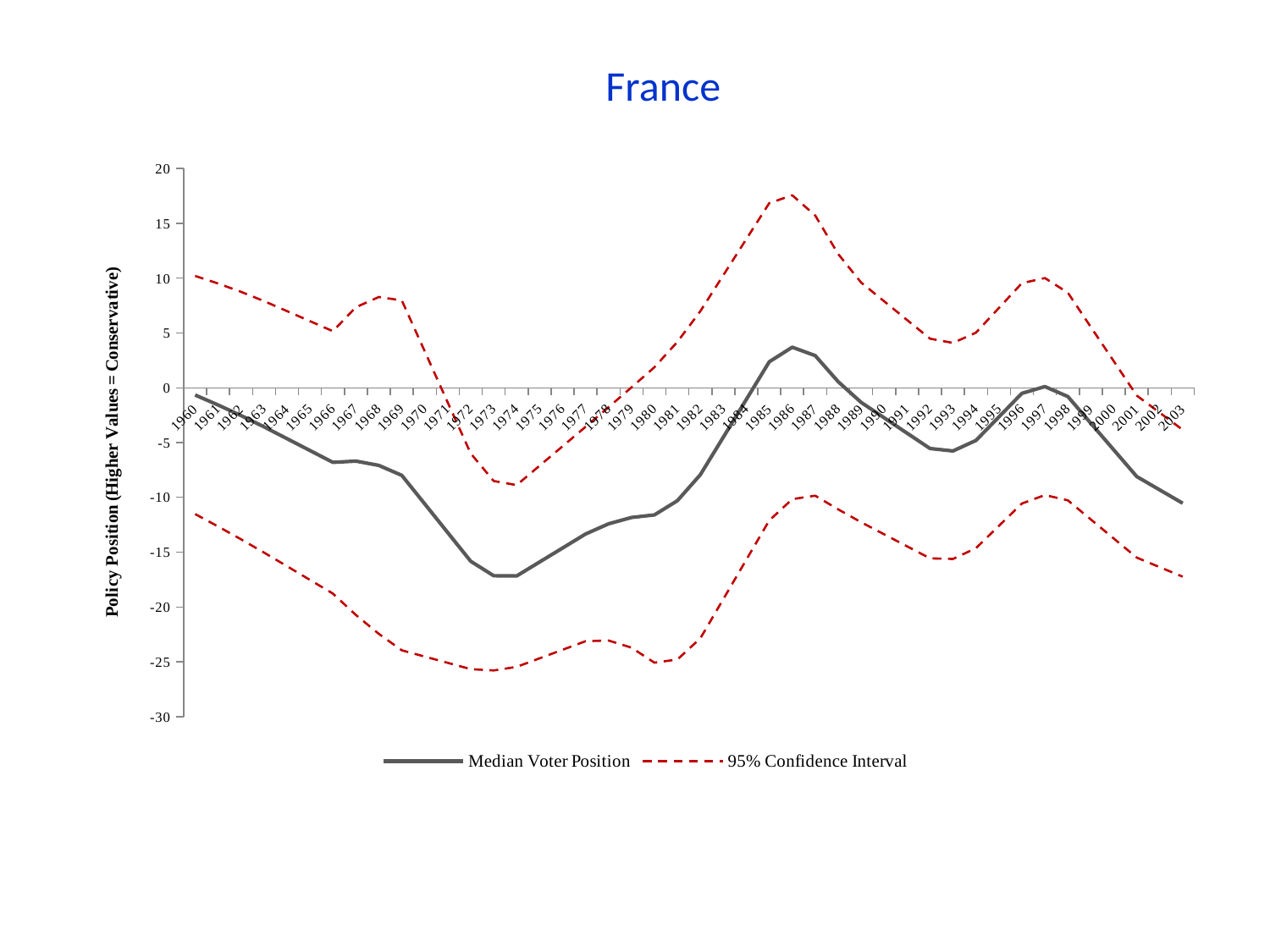
What kind of chart is shown on the slide? line chart Is the Median Voter Position in 1974 greater or less than -15? less How many years are shown along the x axis? 44 What is the label of the vertical axis? Policy Position (Higher Values = Conservative) How many series does the legend list? 2 Which is larger, the Median Voter Position in 1986 or in 1974? 1986 In which year does the Median Voter Position reach its highest value? 1986 What is the title of the chart? France Does the Median Voter Position rise or fall from 1960 to 1974? fall Is the Median Voter Position in 2003 greater or less than -5? less Is the upper 95% Confidence Interval line in 1986 greater or less than 15? greater